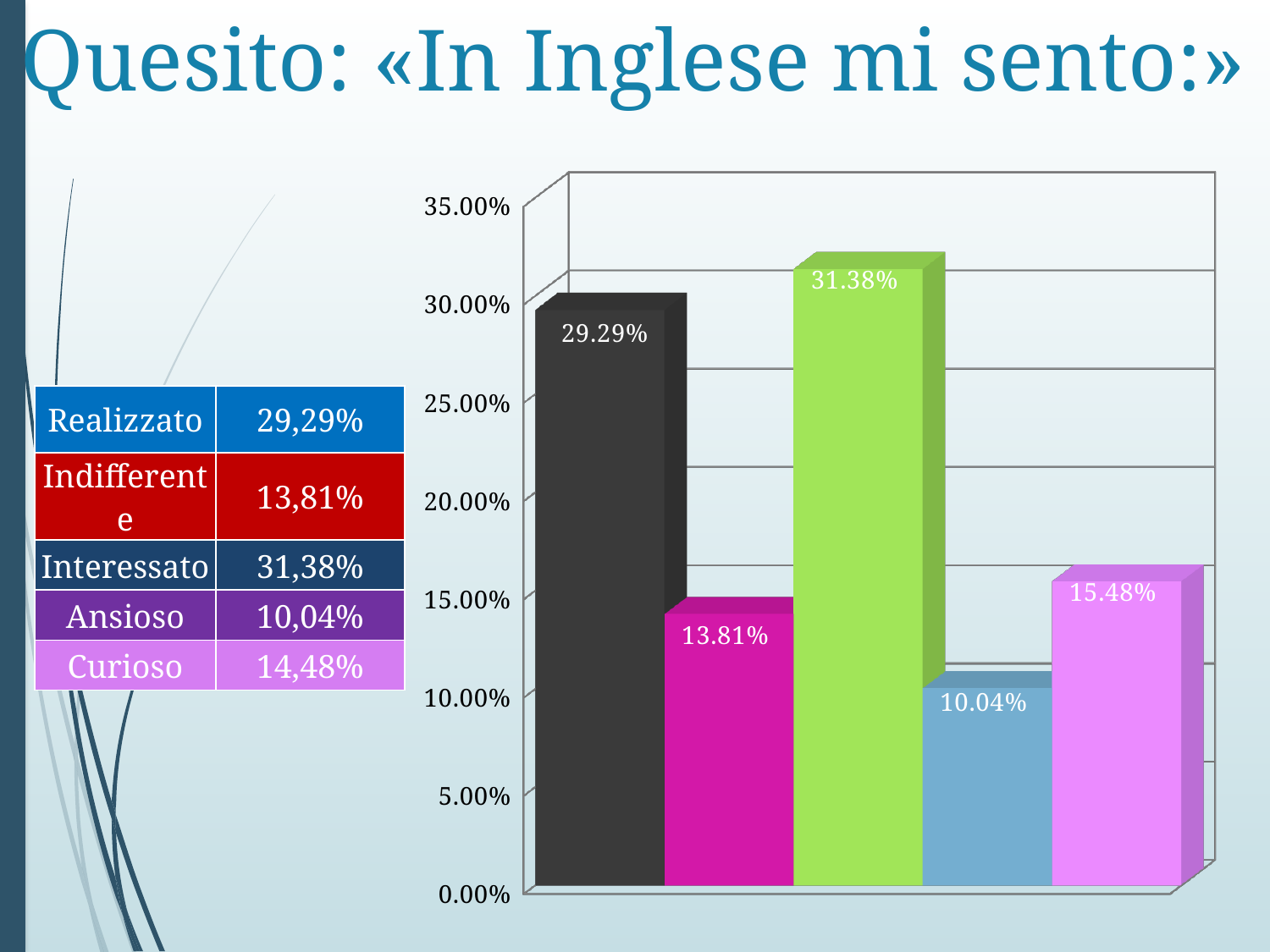
Which bar in the chart has the highest value? The third (green) bar, 31.38% Which bar in the chart has the lowest value? The fourth (light blue) bar, 10.04% How many bars are plotted in the chart? 5 What value is printed on the green bar of the chart? 31.38% What is the difference between the green bar (31.38%) and the black bar (29.29%)? 2.09% What value is printed on the magenta (second) bar of the chart? 13.81% What value is printed on the first (black) bar of the chart? 29.29% Which is larger, the value of the second (magenta) bar or the fifth (pink) bar? The fifth (pink) bar, 15.48% What type of chart is shown on the slide? Bar chart What is the difference between the magenta bar (13.81%) and the light blue bar (10.04%)? 3.77% What value is printed on the light blue (fourth) bar of the chart? 10.04% What value is printed on the last (pink) bar of the chart? 15.48%